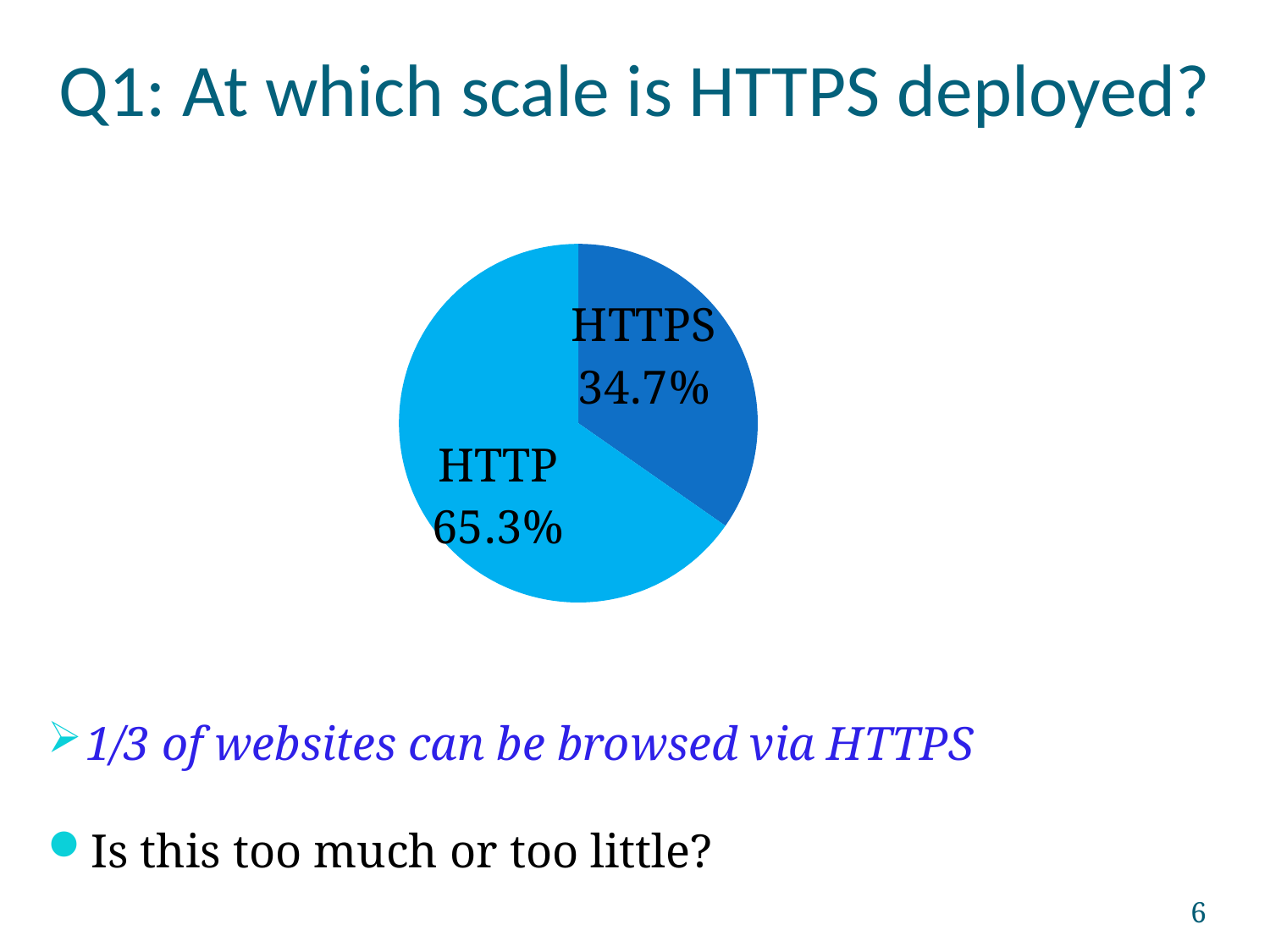
What percentage of the pie is labelled HTTP? 65.3% Which is larger, the HTTP slice or the HTTPS slice? HTTP What is the difference in percentage points between the HTTP and HTTPS slices? 30.6 What percentage of the pie is labelled HTTPS? 34.7% Which slice of the pie is the largest? HTTP Is the HTTPS share greater or less than 50%? less Which slice of the pie is the smallest? HTTPS What is the title of the slide containing the pie chart? Q1: At which scale is HTTPS deployed? Which slice of the pie is drawn in the darker blue colour? HTTPS What share of the pie does the HTTPS slice represent? 34.7% How many slices does the pie chart have? 2 What kind of chart is shown on the slide? pie chart